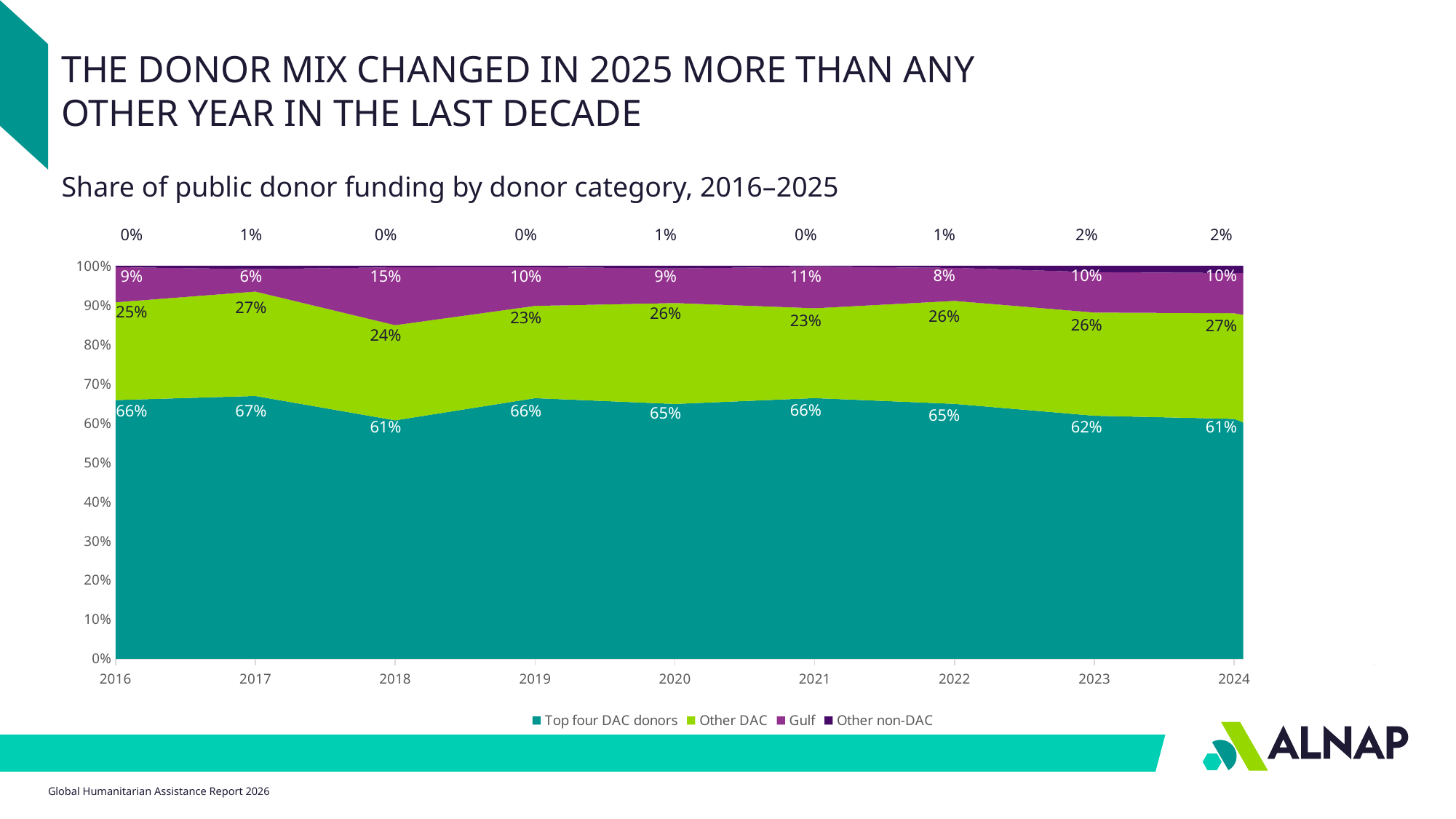
What share of public donor funding came from Gulf donors in 2018? 15% What kind of chart is shown on the slide? Stacked area chart How many years are plotted along the x axis of the chart? 9 In which year was the Gulf share of public donor funding lowest? 2017 Was the Other DAC share larger in 2017 or in 2018? 2017 What share of public donor funding came from the Top four DAC donors in 2017? 67% By how many percentage points did the Top four DAC donors' share fall between 2017 and 2024? 6 percentage points Does the Top four DAC donors' share rise or fall from 2021 to 2024? Fall What share of public donor funding came from Other DAC donors in 2024? 27% In which year was the Gulf share of public donor funding highest? 2018 How many series does the chart's legend list? 4 What share of public donor funding came from Other non-DAC donors in 2023? 2%